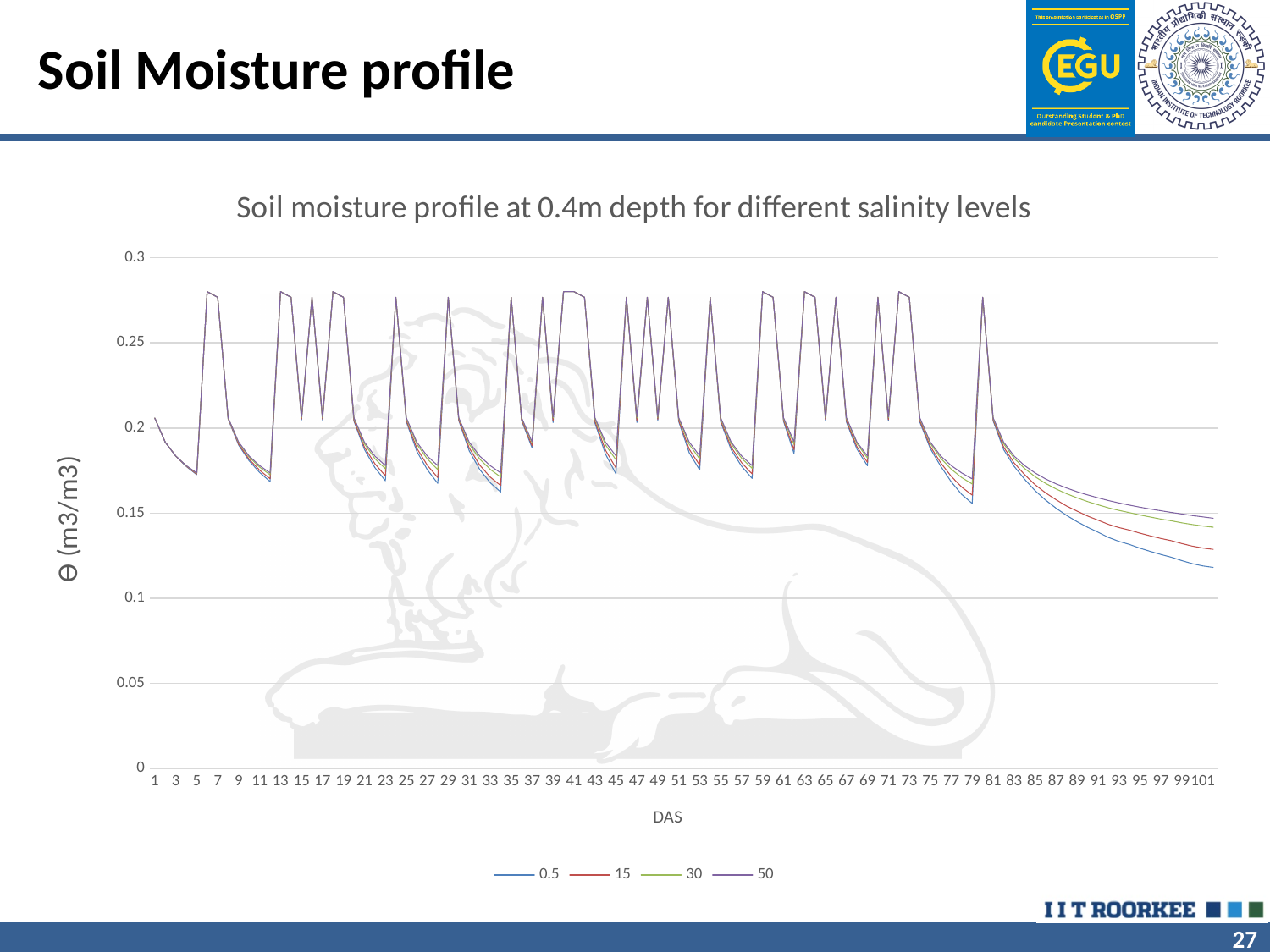
What is the label of the x axis? DAS At DAS 101, is the value for the 50 series greater or less than 0.1? greater What is the title of the chart? Soil moisture profile at 0.4m depth for different salinity levels Do the values rise or fall along the x axis from DAS 81 to DAS 101? fall At DAS 101, which is larger: the value for the 15 series or the value for the 0.5 series? 15 How many series does the legend list? 4 What is the highest value shown on the y axis? 0.3 What kind of chart is shown on the slide? line chart At DAS 101, is the value for the 0.5 series greater or less than 0.15? less Which series has the highest value at DAS 101? 50 Which series has the lowest value at DAS 101? 0.5 Is the highest peak value reached by the series greater or less than 0.25? greater